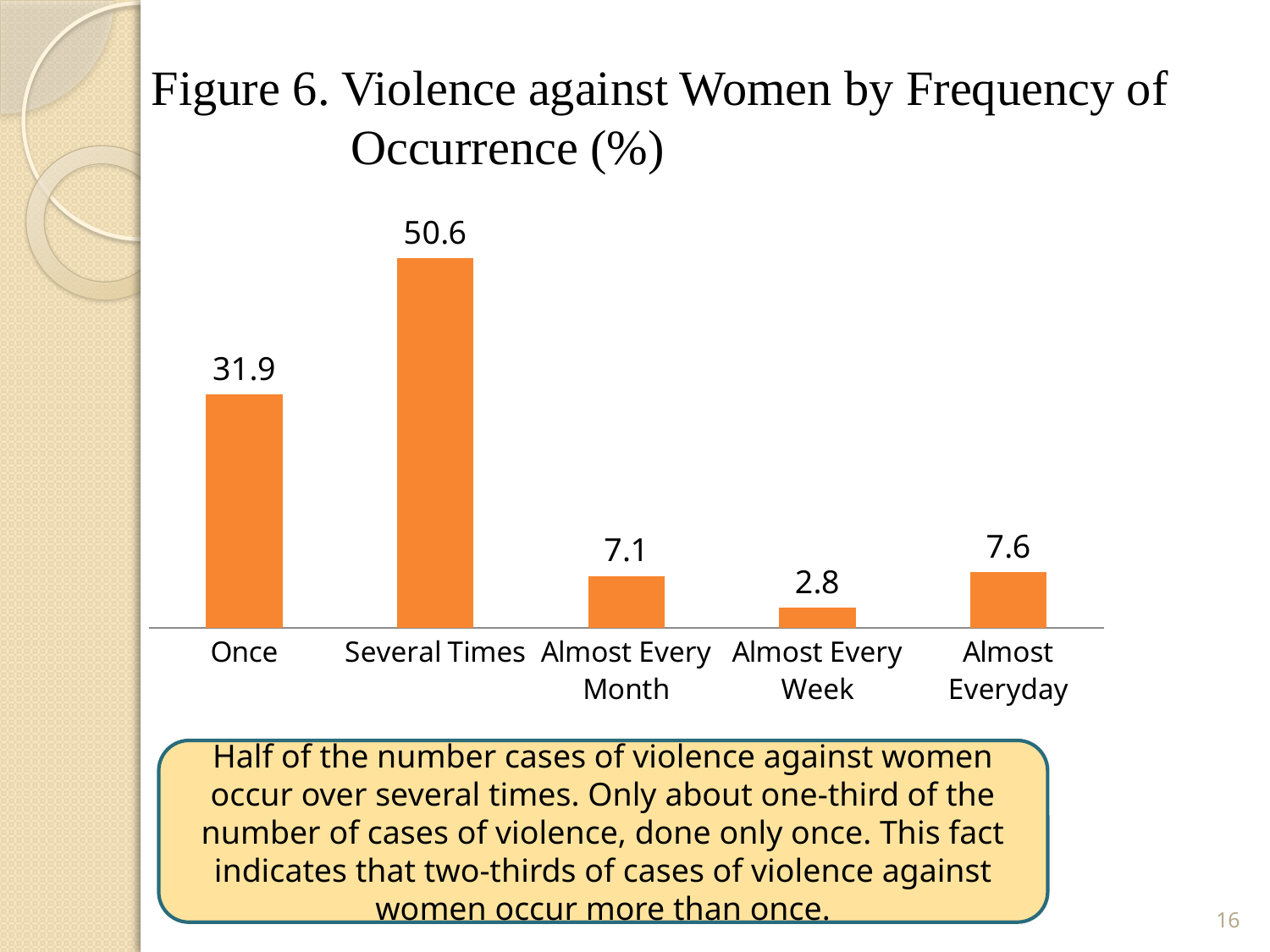
How many frequency categories are shown in the chart? 5 What kind of chart is shown on the slide? Bar chart What is the value for Once? 31.9 Which is larger, the value for Almost Every Month or the value for Almost Every Week? Almost Every Month What is the difference between the values for Several Times and Once? 18.7 What is the title of the chart? Figure 6. Violence against Women by Frequency of Occurrence (%) What is the value for Several Times? 50.6 Which frequency category has the highest value? Several Times What is the difference between the values for Almost Everyday and Almost Every Month? 0.5 What is the value for Almost Every Week? 2.8 What is the value for Almost Everyday? 7.6 Which frequency category has the lowest value? Almost Every Week